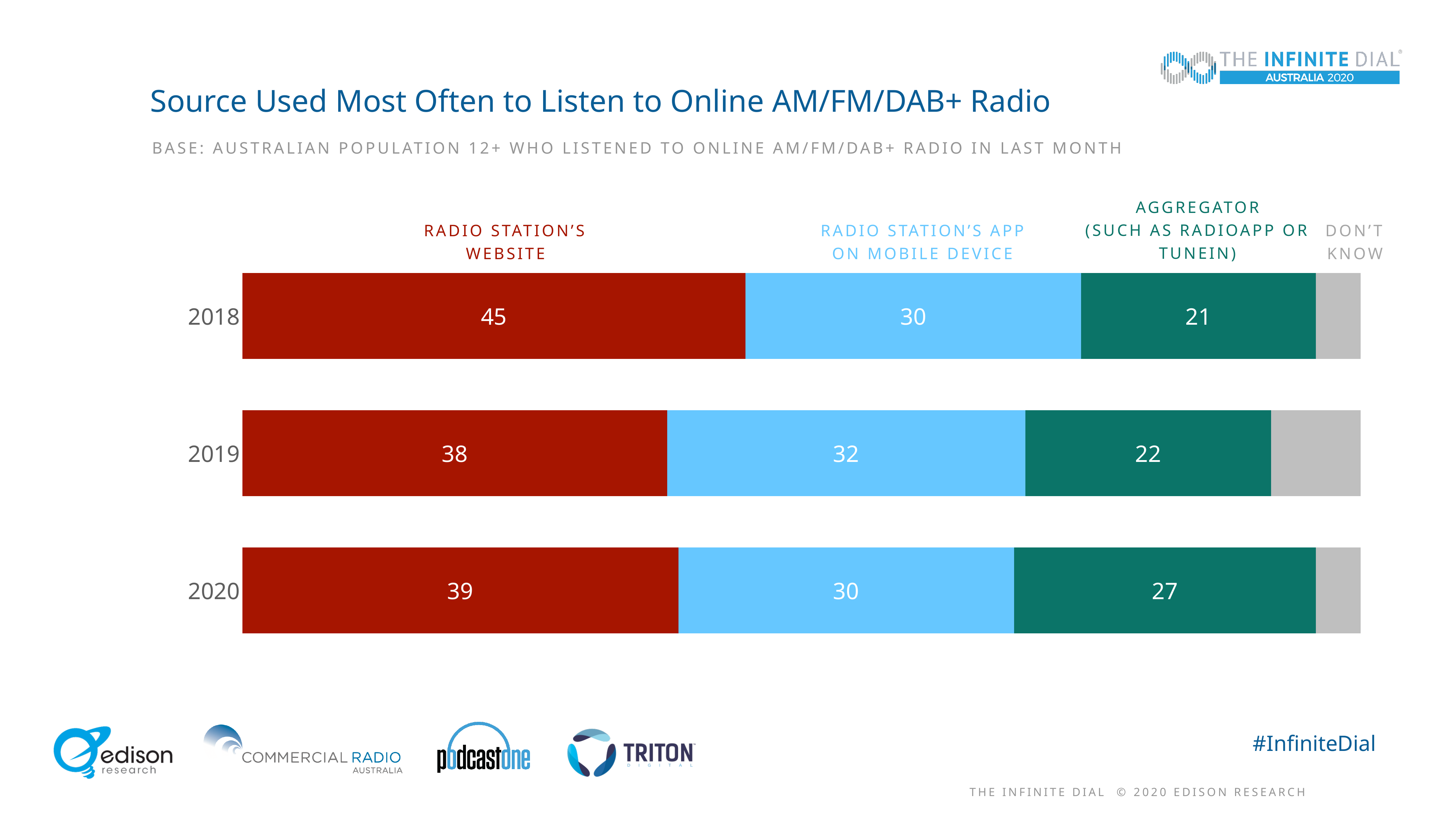
In which year was the aggregator value lowest? 2018 Does the aggregator value rise or fall from 2018 to 2020? Rise By how much did the aggregator value increase from 2018 to 2020? 6 How many series (sources) does the chart show? 4 What kind of chart is shown on the slide? Stacked bar chart What is the difference between the radio station's website value in 2018 and in 2019? 7 In 2019, which was larger: radio station's website or radio station's app on mobile device? Radio station's website What is the value for aggregator (such as RadioApp or TuneIn) in 2020? 27 How many years are shown in the chart? 3 What percentage of listeners used the radio station's website most often in 2018? 45 In which year was the radio station's website value highest? 2018 What is the value for the radio station's app on mobile device in 2019? 32